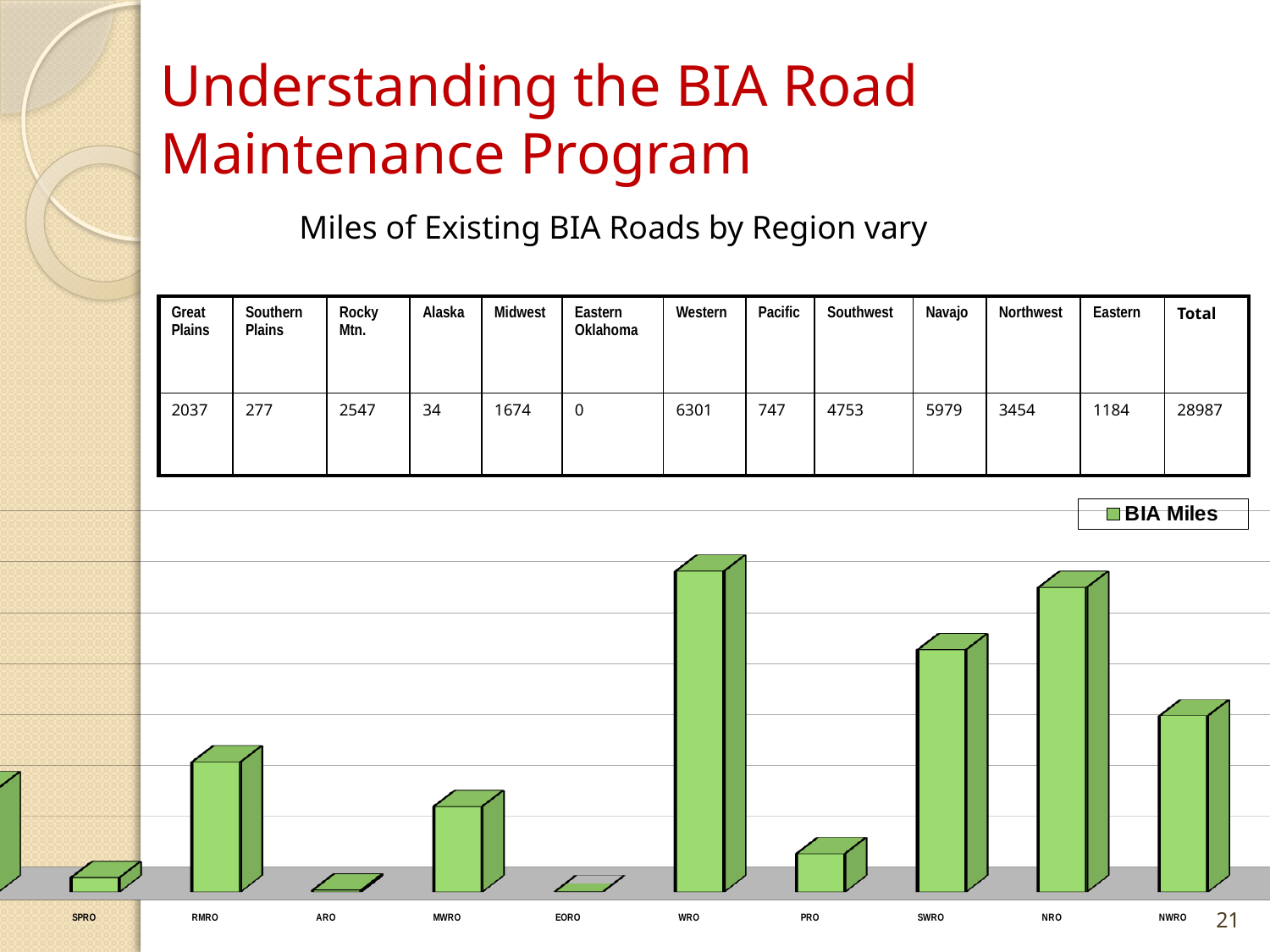
According to the table on the slide, how many miles of existing BIA roads are in the Western region? 6301 In the chart, which bar is taller, WRO or NRO? WRO How many labelled categories are shown along the x axis of the chart? 10 According to the table on the slide, what is the total miles of existing BIA roads? 28987 What kind of chart is shown at the bottom of the slide? bar chart In the chart, which bar is taller, SWRO or NWRO? SWRO Which category has the tallest bar in the chart? WRO In the chart, which bar is taller, RMRO or MWRO? RMRO According to the table on the slide, which region has the fewest miles of existing BIA roads? Eastern Oklahoma What is the series name shown in the chart's legend? BIA Miles How many series does the chart's legend list? 1